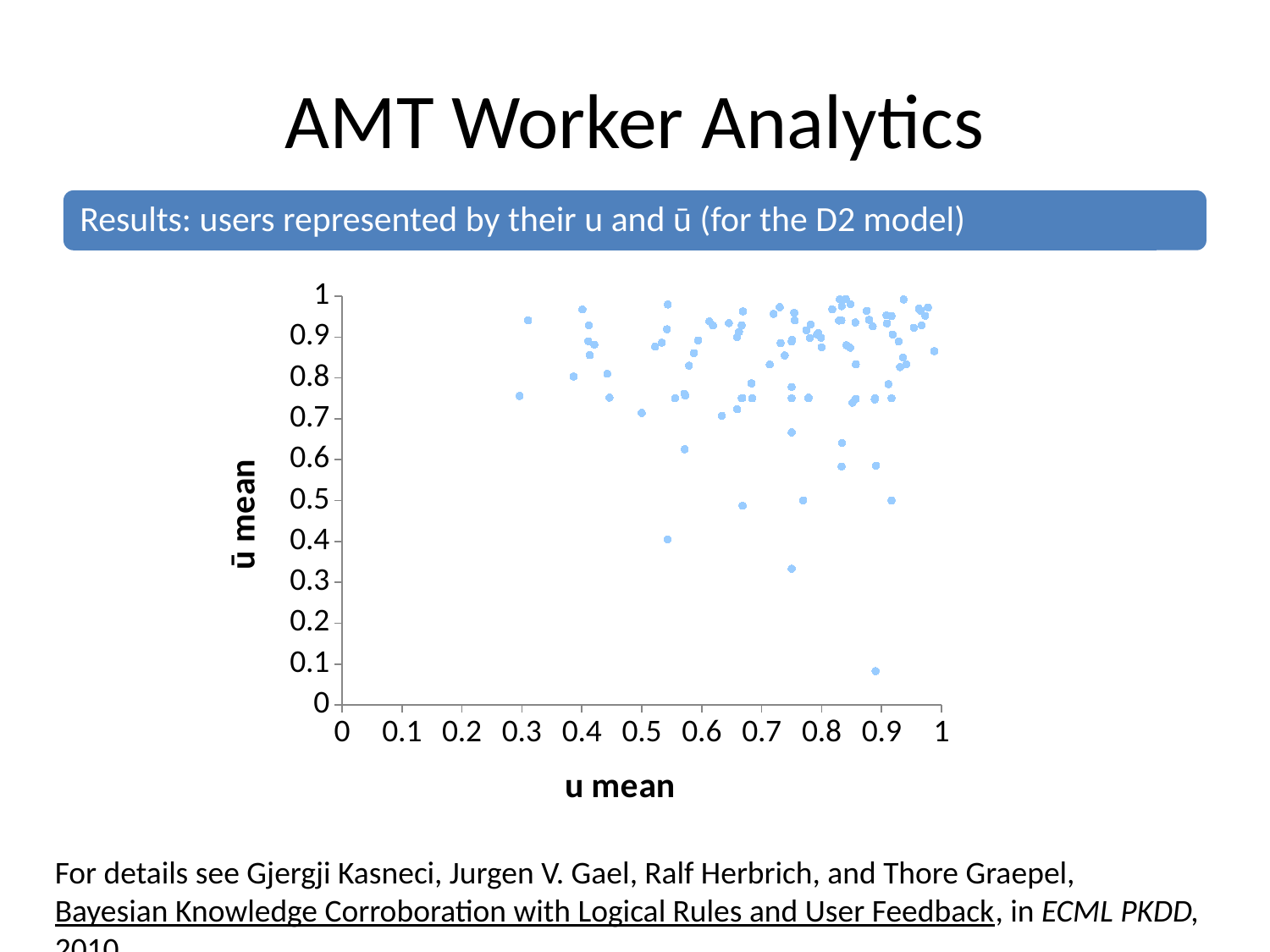
Is the u mean of the leftmost point in the chart greater or less than 0.4? less What kind of chart is shown on the slide? scatter chart What is the label of the vertical axis of the chart? ū mean What is the highest tick value shown on the horizontal axis? 1 Is the u mean of the lowest point in the chart greater or less than 0.8? greater What is the label of the horizontal axis of the chart? u mean Is the ū mean of the lowest point in the chart greater or less than 0.1? less What is the highest tick value shown on the vertical axis? 1